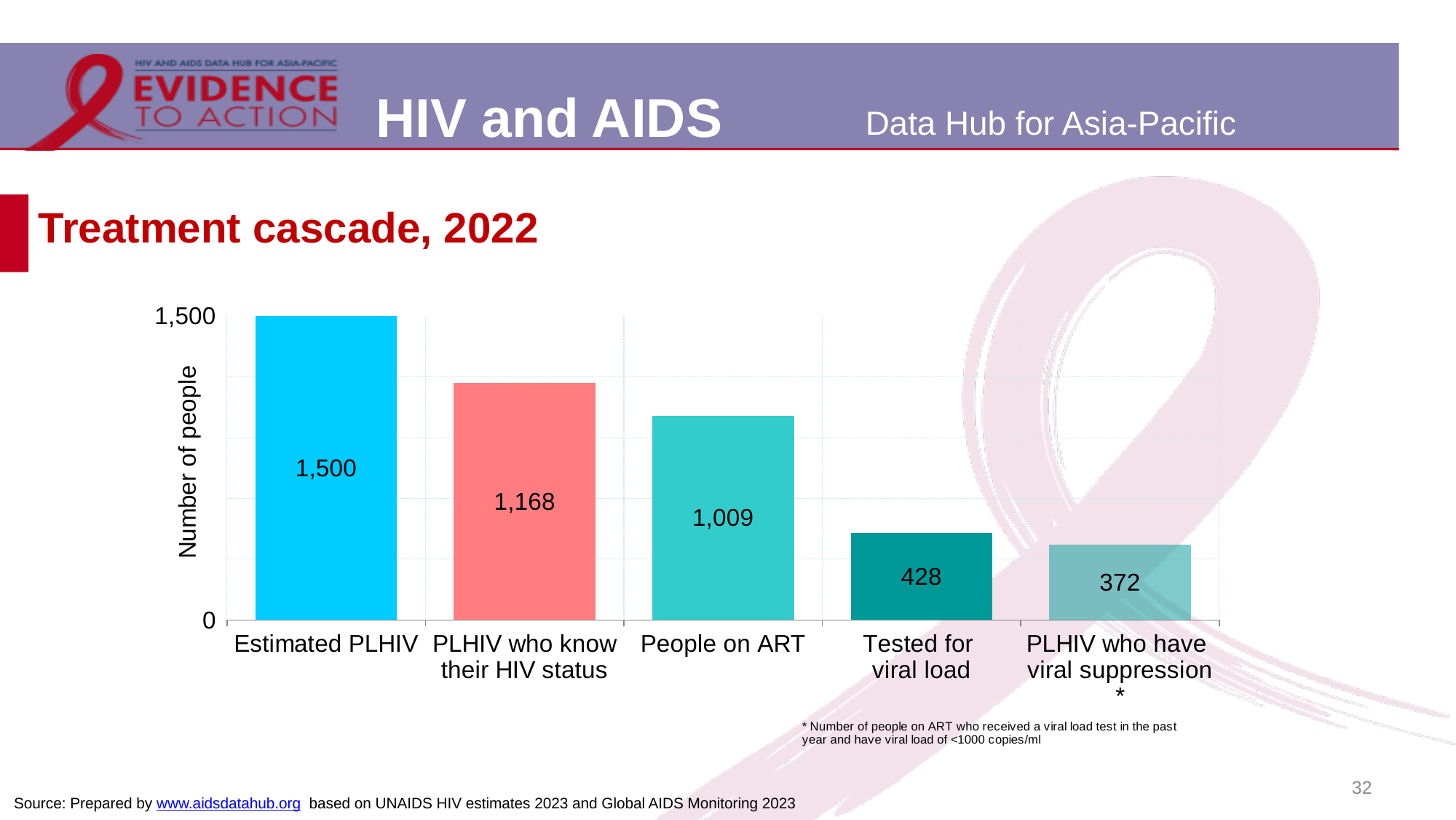
Which category has the lowest value? PLHIV who have viral suppression How many categories are shown in the chart? 5 What is the value for Tested for viral load? 428 Which is larger, People on ART or Tested for viral load? People on ART What is the value for Estimated PLHIV? 1,500 What is the value for PLHIV who have viral suppression? 372 What is the difference between Estimated PLHIV and PLHIV who know their HIV status? 332 What kind of chart is shown on the slide? Bar chart What is the difference between Tested for viral load and PLHIV who have viral suppression? 56 What is the value for People on ART? 1,009 Which category has the highest value? Estimated PLHIV What is the value for PLHIV who know their HIV status? 1,168